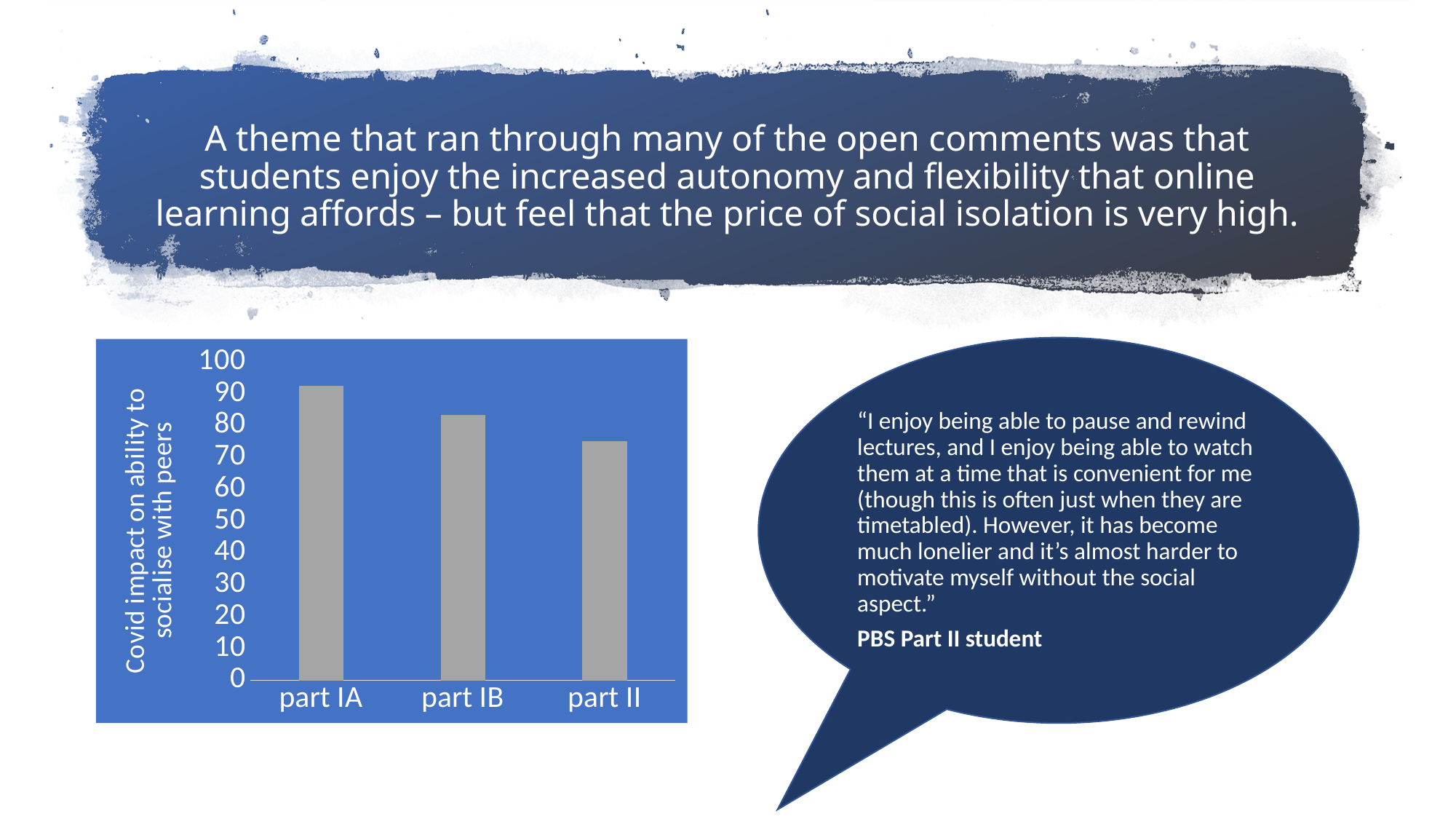
What is the highest tick value shown on the vertical axis of the bar chart? 100 Which is larger on the bar chart, the value for part IA or the value for part II? part IA Which category has the lowest value on the bar chart? part II What kind of chart is shown on the slide? bar chart Which category has the highest value on the bar chart? part IA Is the value for part IB greater or less than 80? greater Which is larger on the bar chart, the value for part IB or the value for part II? part IB Is the value for part IA greater or less than 90? greater What is the label on the vertical axis of the bar chart? Covid impact on ability to socialise with peers How many categories are plotted on the bar chart? 3 Is the value for part II greater or less than 80? less Do the values on the bar chart rise or fall from part IA to part II? fall